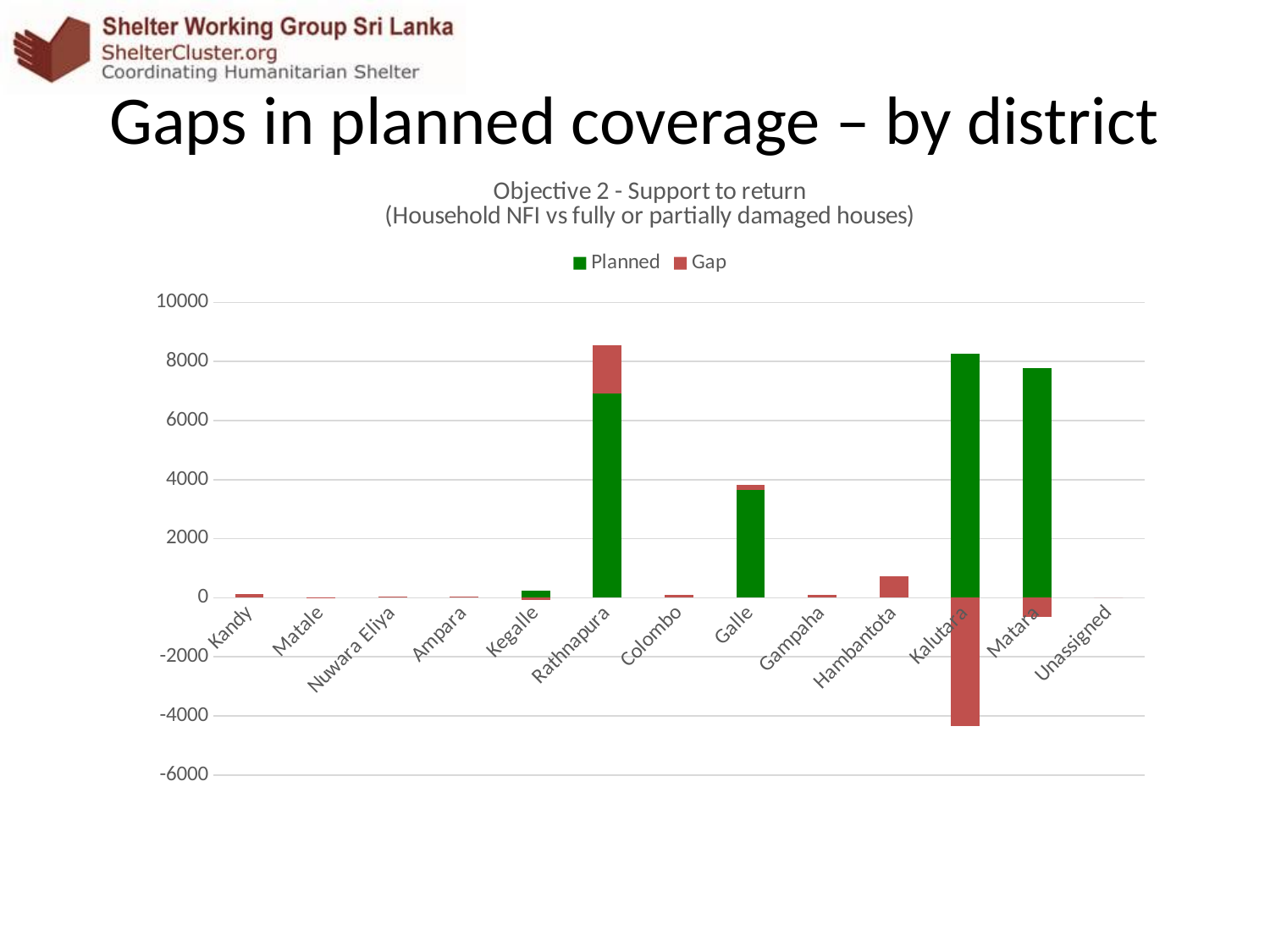
How many districts (categories) are shown on the x axis? 13 How many series does the legend list? 2 Is the Planned value for Galle greater or less than 4000? less What kind of chart is shown on the slide? Stacked bar chart Is the Gap value for Kalutara greater or less than -2000? less Which district has the highest Planned value? Kalutara Which district has the larger Planned value, Rathnapura or Matara? Matara Which district has the largest negative Gap value? Kalutara Is the Planned value for Rathnapura greater or less than 6000? greater Which district has the largest positive Gap value? Rathnapura Which colour represents the Gap series in the chart? Red What is the title of the chart? Objective 2 - Support to return (Household NFI vs fully or partially damaged houses)